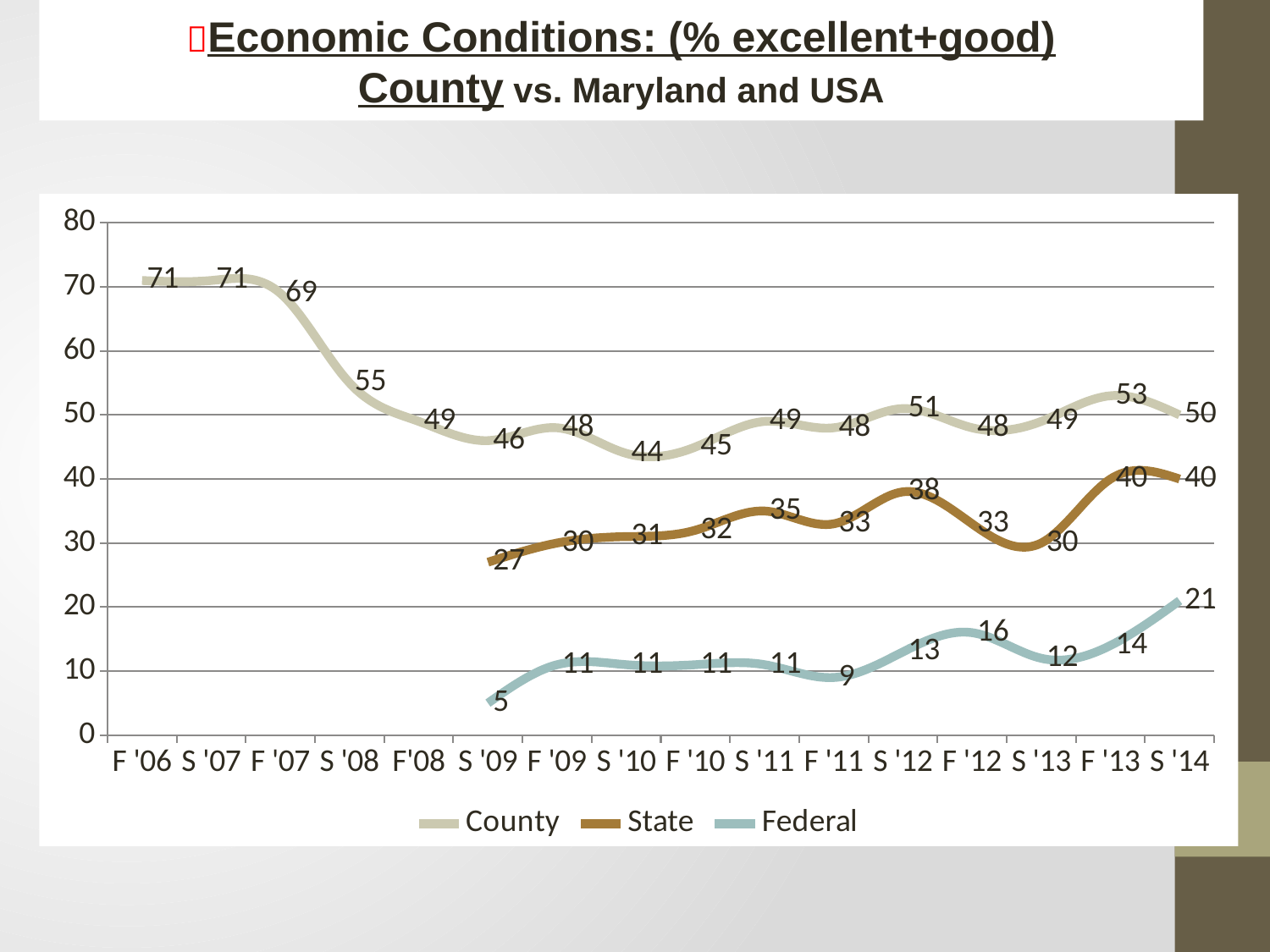
How many time points are shown on the x axis? 16 By how much did the State value increase from S '09 to S '14? 13 What is the State value at S '14? 40 At which point does the Federal series reach its highest value? S '14 What is the County value at F '06? 71 At which point is the State series at its lowest value? S '09 At S '12, which is larger: the State value or the Federal value? State At which point is the County series at its lowest value? S '10 What kind of chart is shown on the slide? Line chart How much higher is the County value at F '06 than at S '14? 21 What is the Federal value at S '09? 5 How many series does the legend list? 3